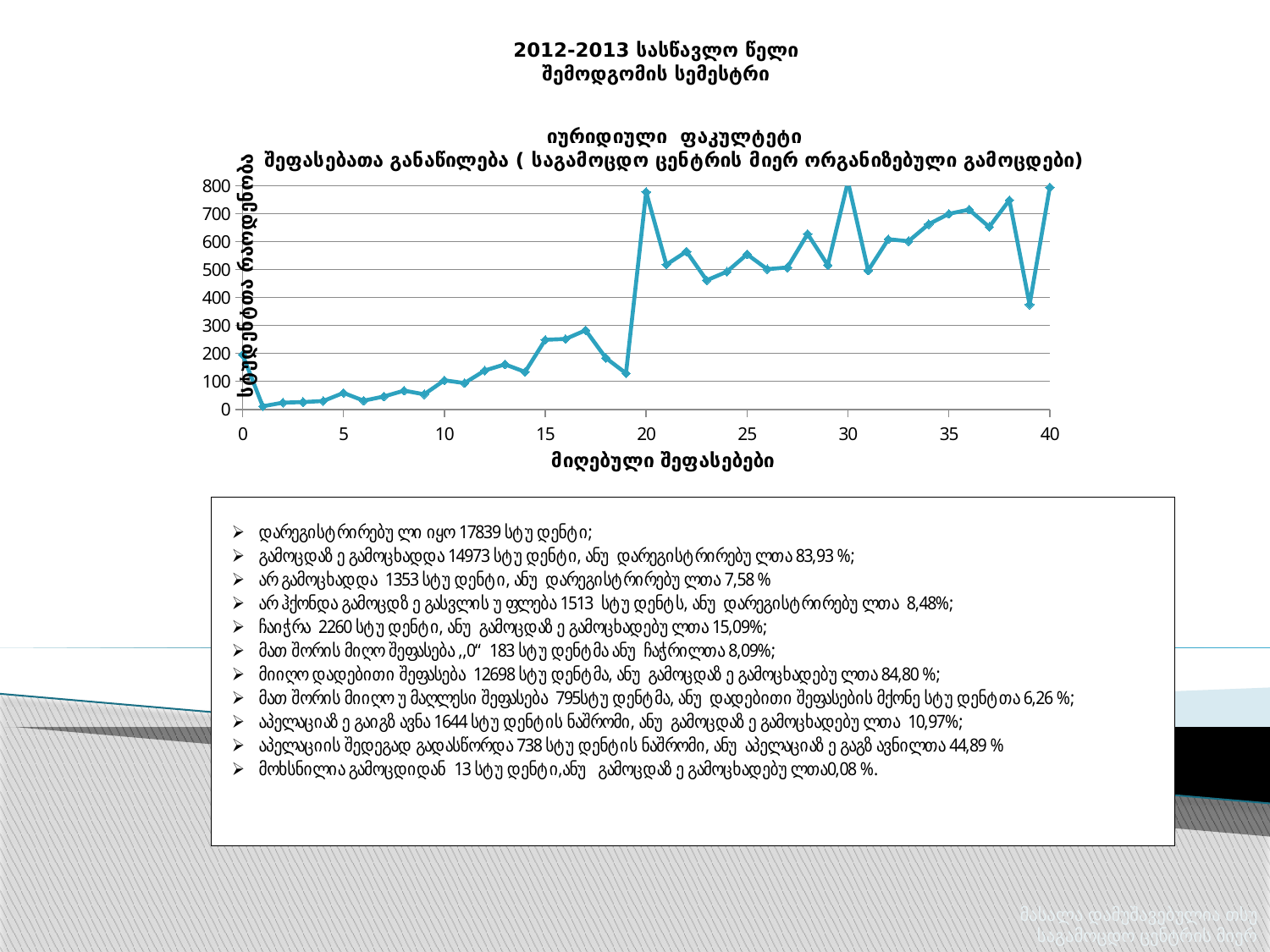
Is the value at x = 15 greater or less than 200? greater Which is larger, the value at x = 19 or the value at x = 20? x = 20 Is the value at x = 1 greater or less than 100? less Is the value at x = 20 greater or less than 700? greater What is the label of the y axis of the chart? სტუდენტთა რაოდენობა What is the label of the x axis of the chart? მიღებული შეფასებები Which is larger, the value at x = 5 or the value at x = 35? x = 35 Do the values generally rise or fall between x = 10 and x = 17? rise What kind of chart is shown on the slide? line chart